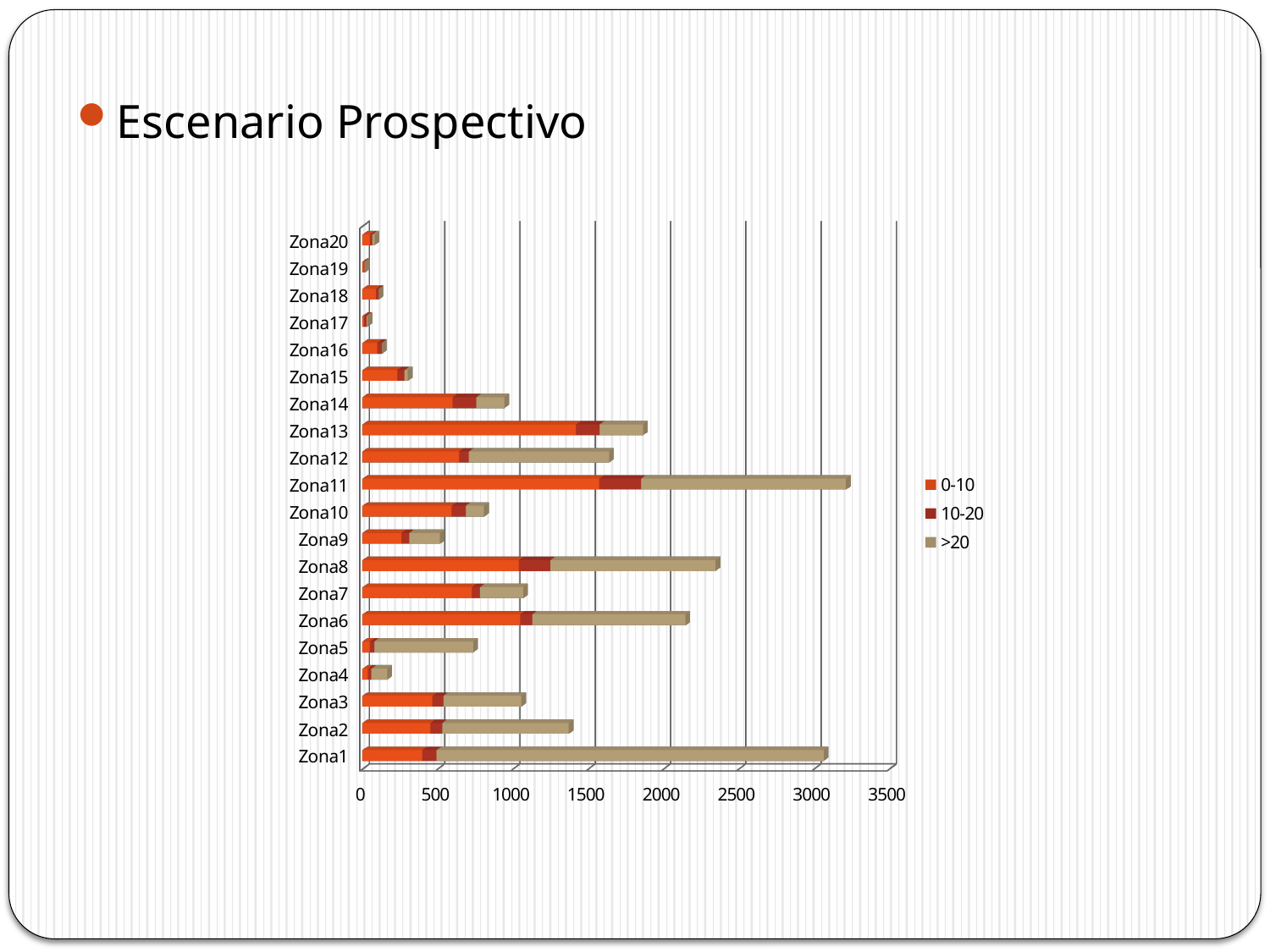
Which zone has the longest total bar? Zona11 Is the total value for Zona8 greater or less than 2000? greater What are the three series named in the legend? 0-10, 10-20, >20 Is the total value for Zona11 greater or less than 3000? greater Which has the larger total bar, Zona5 or Zona4? Zona5 Which has the larger total bar, Zona8 or Zona6? Zona8 What kind of chart is shown on the slide? Stacked bar chart Is the total value for Zona9 greater or less than 1000? less Which has the larger total bar, Zona2 or Zona3? Zona2 How many zones (categories) are plotted on the chart? 20 How many series does the legend list? 3